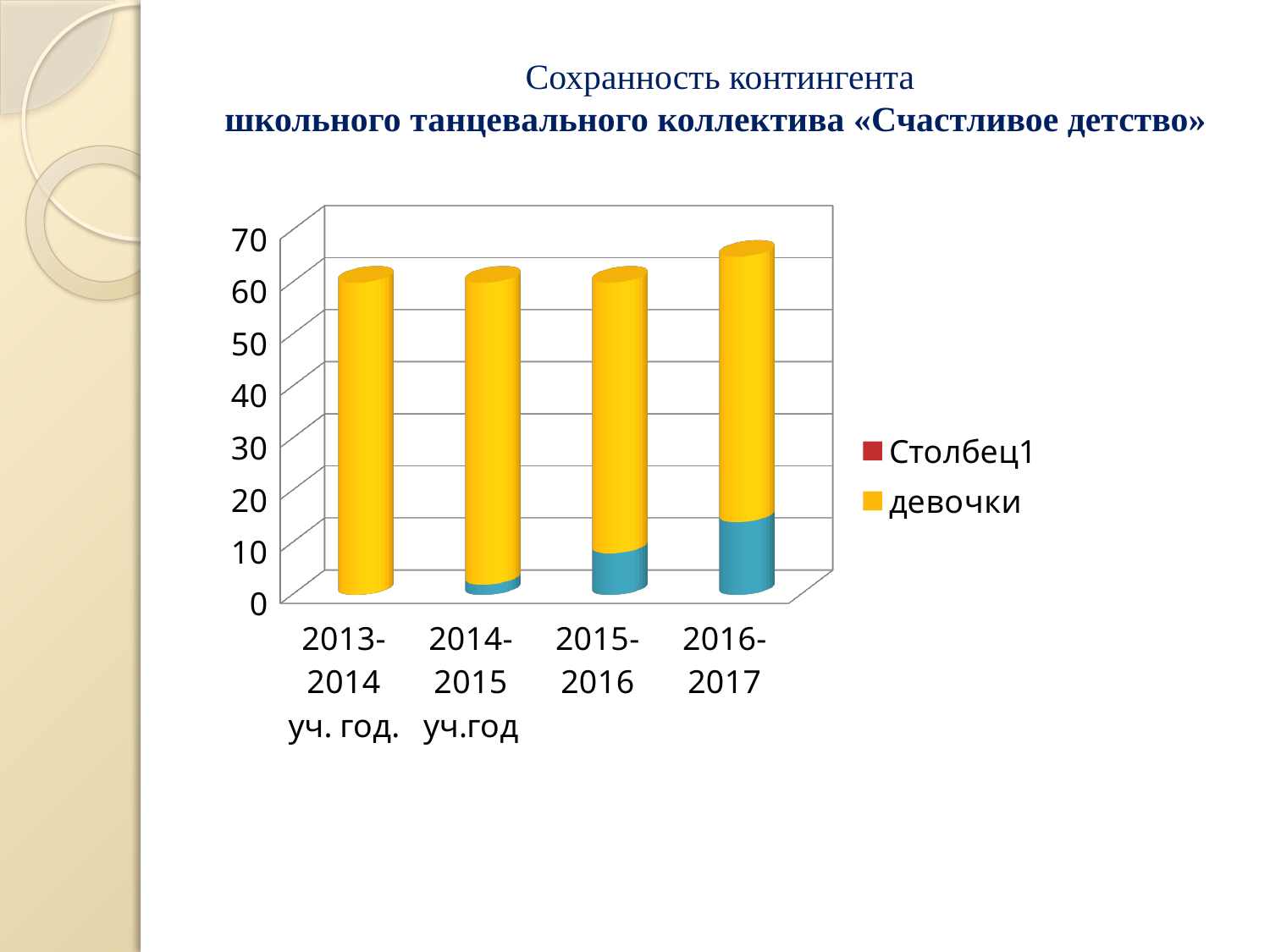
Is the blue (bottom) segment for 2016-2017 greater or less than 20? less Is the total bar for 2014-2015 уч.год greater or less than 70? less What is the name of the first series listed in the legend? Столбец1 What kind of chart is shown on the slide? bar chart Is the blue (bottom) segment for 2014-2015 уч.год greater or less than 10? less Which bar is taller: 2013-2014 or 2016-2017? 2016-2017 How many academic-year categories are shown on the x axis? 4 What colour represents the series 'девочки' in the legend? yellow How many series does the legend list? 2 Which academic year has the tallest bar? 2016-2017